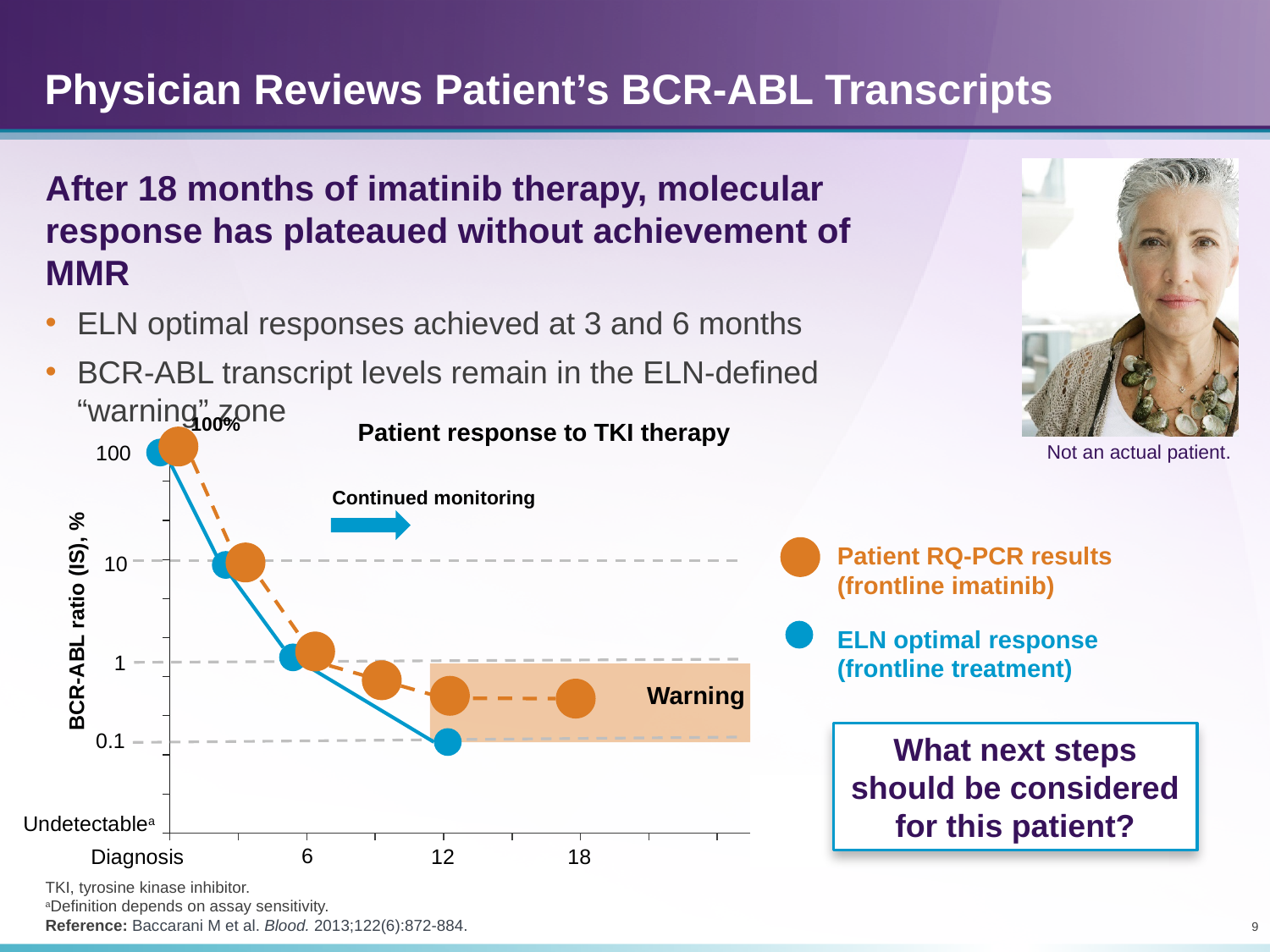
How many data points are plotted for the Patient RQ-PCR results series? 6 What is the labelled value of the Patient RQ-PCR results series at Diagnosis? 100% How many data points are plotted for the ELN optimal response series? 4 Do the Patient RQ-PCR results values rise or fall from Diagnosis to 18 months? fall What is the title of the chart? Patient response to TKI therapy Is the ELN optimal response value at 12 months greater or less than 1? less Is the Patient RQ-PCR results value at 18 months greater or less than 1? less What kind of chart is shown on the slide? line chart How many series does the chart's legend list? 2 At 12 months, which series has the higher value: Patient RQ-PCR results or ELN optimal response? Patient RQ-PCR results Is the Patient RQ-PCR results value at 18 months greater or less than 0.1? greater What label is shown in the shaded zone on the right side of the chart? Warning